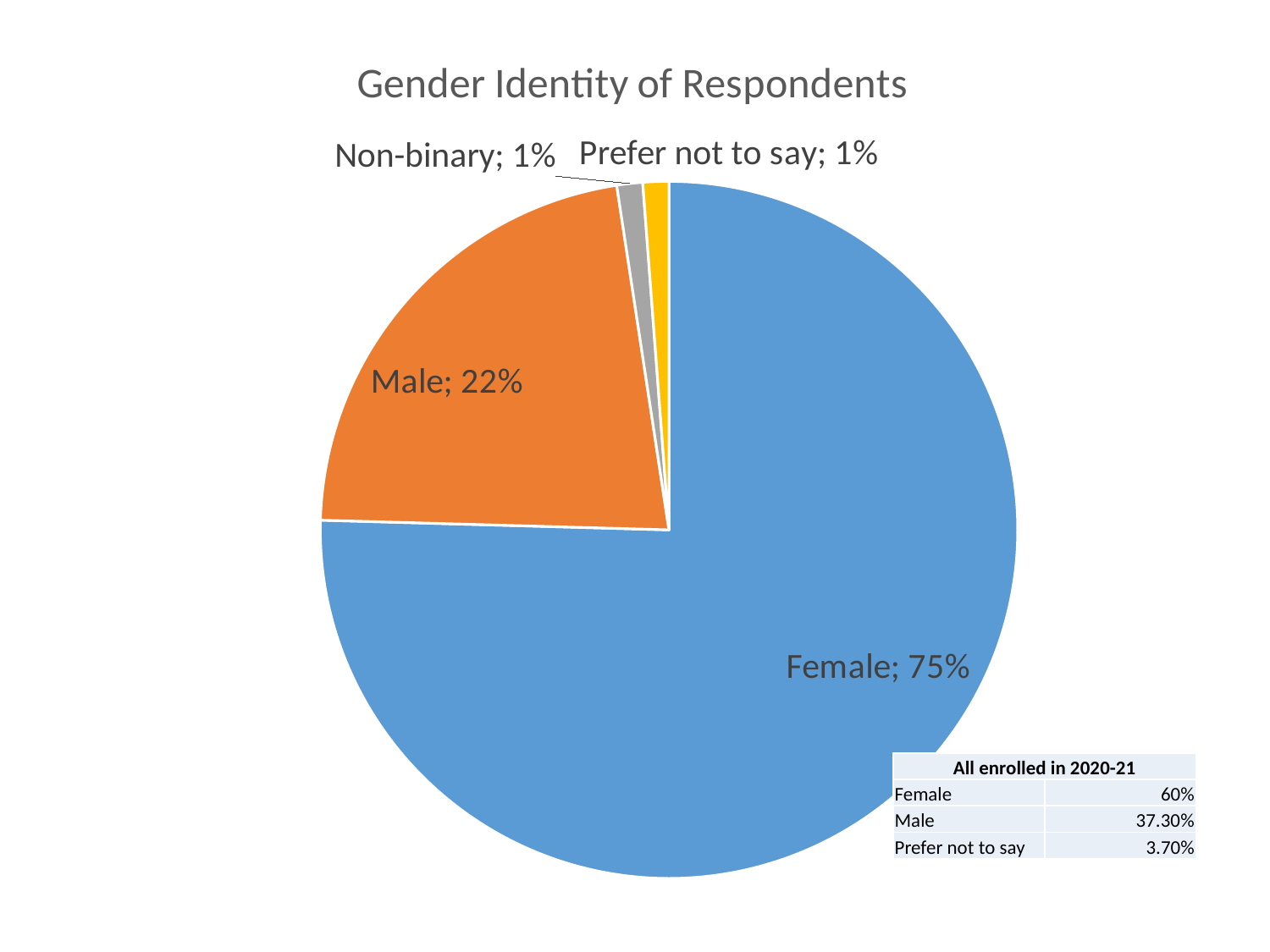
What is the title of the chart? Gender Identity of Respondents What share of respondents chose Prefer not to say? 1% What is the combined share of the Female and Male slices? 97% What share of respondents are Female? 75% What kind of chart is shown on the slide? pie chart What is the difference in percentage points between the Female and Male slices? 53 Which is larger, the Male slice or the Female slice? Female What share of respondents are Non-binary? 1% Which category has the largest slice of the pie? Female What colour is the Male slice? orange How many slices does the pie chart have? 4